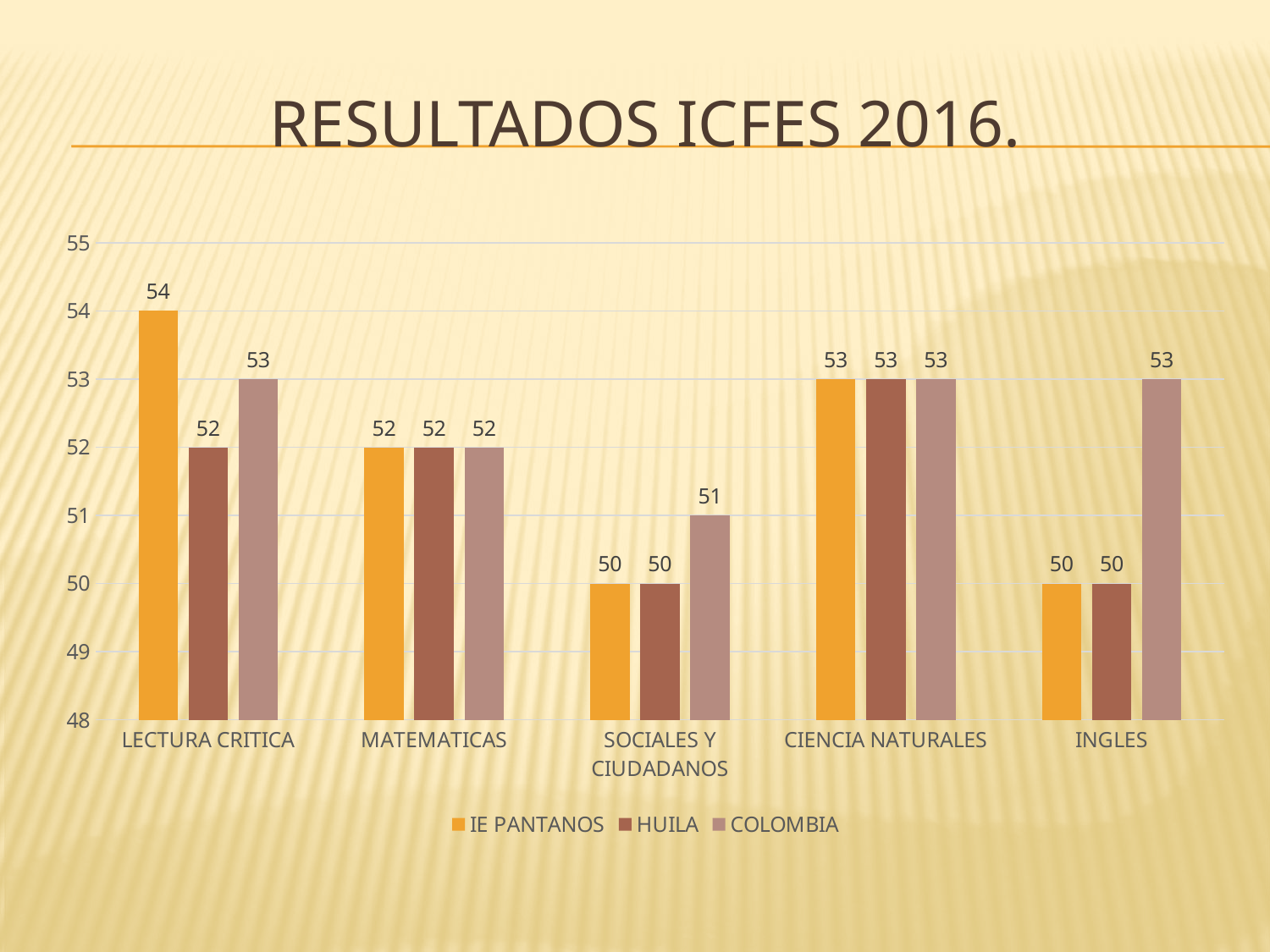
What is the value for IE PANTANOS in LECTURA CRITICA? 54 Which category has the lowest value for COLOMBIA? SOCIALES Y CIUDADANOS How many series does the legend list? 3 Which series is shown in orange? IE PANTANOS What is the difference between the COLOMBIA and IE PANTANOS values in INGLES? 3 What kind of chart is shown on the slide? bar chart Which category has the highest value for IE PANTANOS? LECTURA CRITICA In LECTURA CRITICA, which is larger: the IE PANTANOS value or the HUILA value? IE PANTANOS How many categories are shown on the x axis? 5 What is the title of the slide? RESULTADOS ICFES 2016. What is the value for HUILA in INGLES? 50 What is the value for COLOMBIA in SOCIALES Y CIUDADANOS? 51